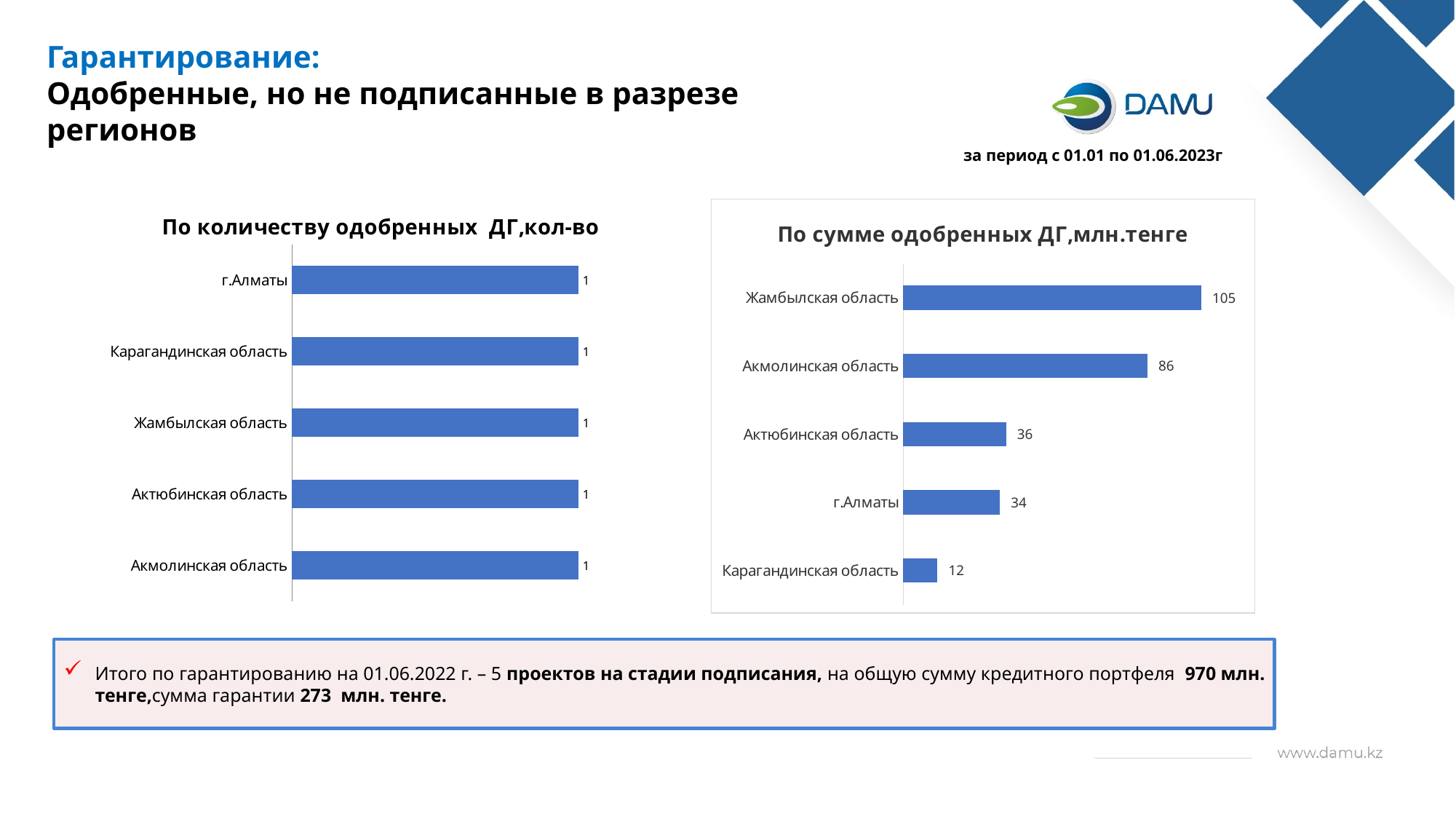
In the chart 'По сумме одобренных ДГ,млн.тенге', what is the value for Акмолинская область? 86 In the chart 'По сумме одобренных ДГ,млн.тенге', what is the total of all five regions? 273 In the chart 'По сумме одобренных ДГ,млн.тенге', which region has the highest value? Жамбылская область In the chart 'По количеству одобренных ДГ,кол-во', what is the value for г.Алматы? 1 In the chart 'По сумме одобренных ДГ,млн.тенге', what is the value for Карагандинская область? 12 In the chart 'По сумме одобренных ДГ,млн.тенге', what is the value for Жамбылская область? 105 In the chart 'По сумме одобренных ДГ,млн.тенге', which is larger: Актюбинская область or г.Алматы? Актюбинская область In the chart 'По сумме одобренных ДГ,млн.тенге', what is the difference between Жамбылская область and Акмолинская область? 19 How many regions are shown in the chart 'По количеству одобренных ДГ,кол-во'? 5 What is the title of the chart on the left side of the slide? По количеству одобренных ДГ,кол-во What type of chart is 'По сумме одобренных ДГ,млн.тенге'? Bar chart In the chart 'По сумме одобренных ДГ,млн.тенге', which region has the lowest value? Карагандинская область